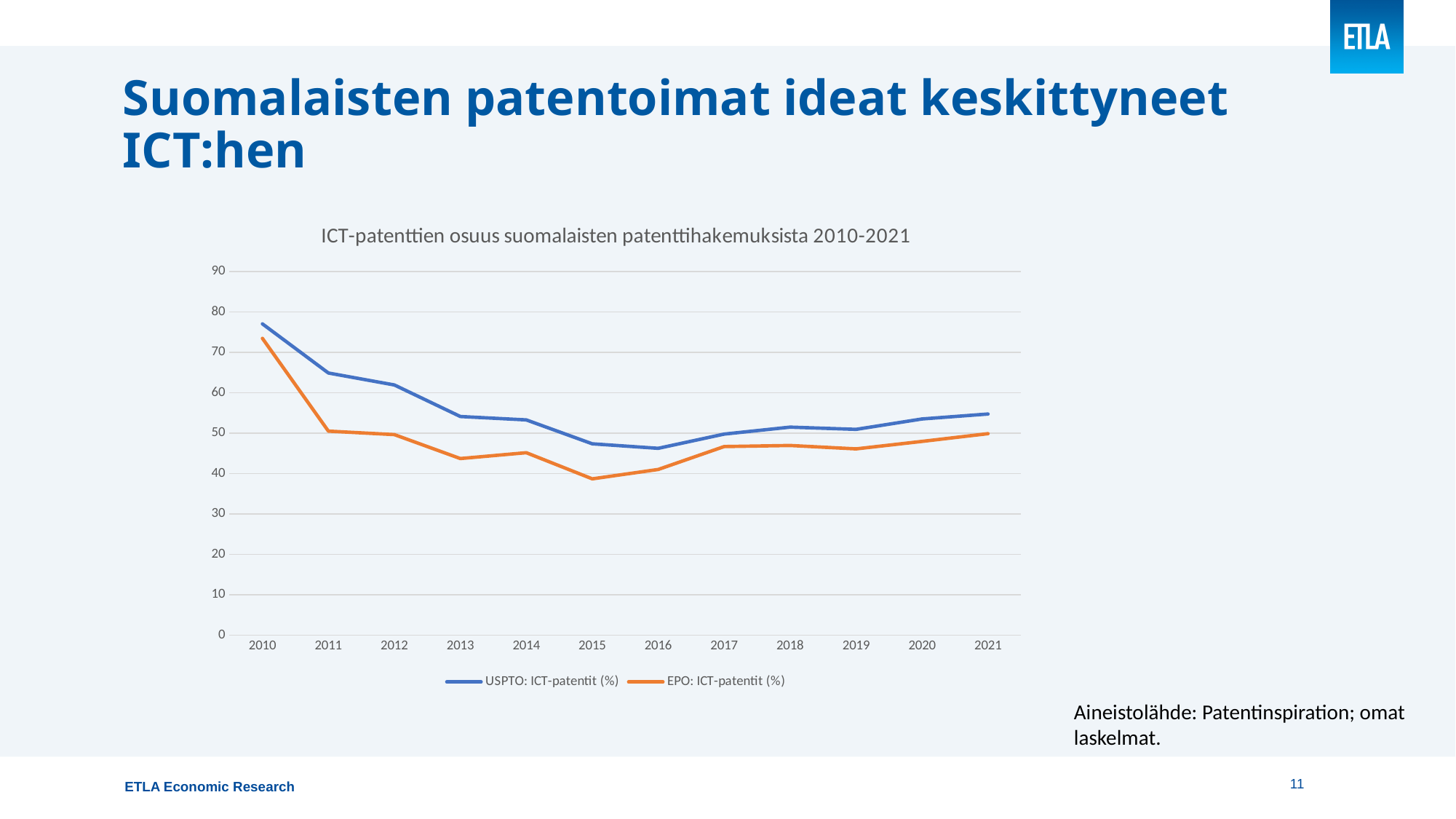
In 2010, which series has the higher value, USPTO: ICT-patentit (%) or EPO: ICT-patentit (%)? USPTO: ICT-patentit (%) Is the value for EPO: ICT-patentit (%) in 2015 greater or less than 40? less What kind of chart is shown on the slide? line chart In which year is the USPTO: ICT-patentit (%) series at its highest? 2010 How many years are plotted along the x axis? 12 In which year is the EPO: ICT-patentit (%) series at its highest? 2010 How many series does the legend list? 2 Is the value for USPTO: ICT-patentit (%) in 2016 greater or less than 50? less In which year is the EPO: ICT-patentit (%) series at its lowest? 2015 What is the title of the chart? ICT-patenttien osuus suomalaisten patenttihakemuksista 2010-2021 Does the USPTO: ICT-patentit (%) series rise or fall from 2010 to 2015? fall Is the value for USPTO: ICT-patentit (%) in 2010 greater or less than 70? greater